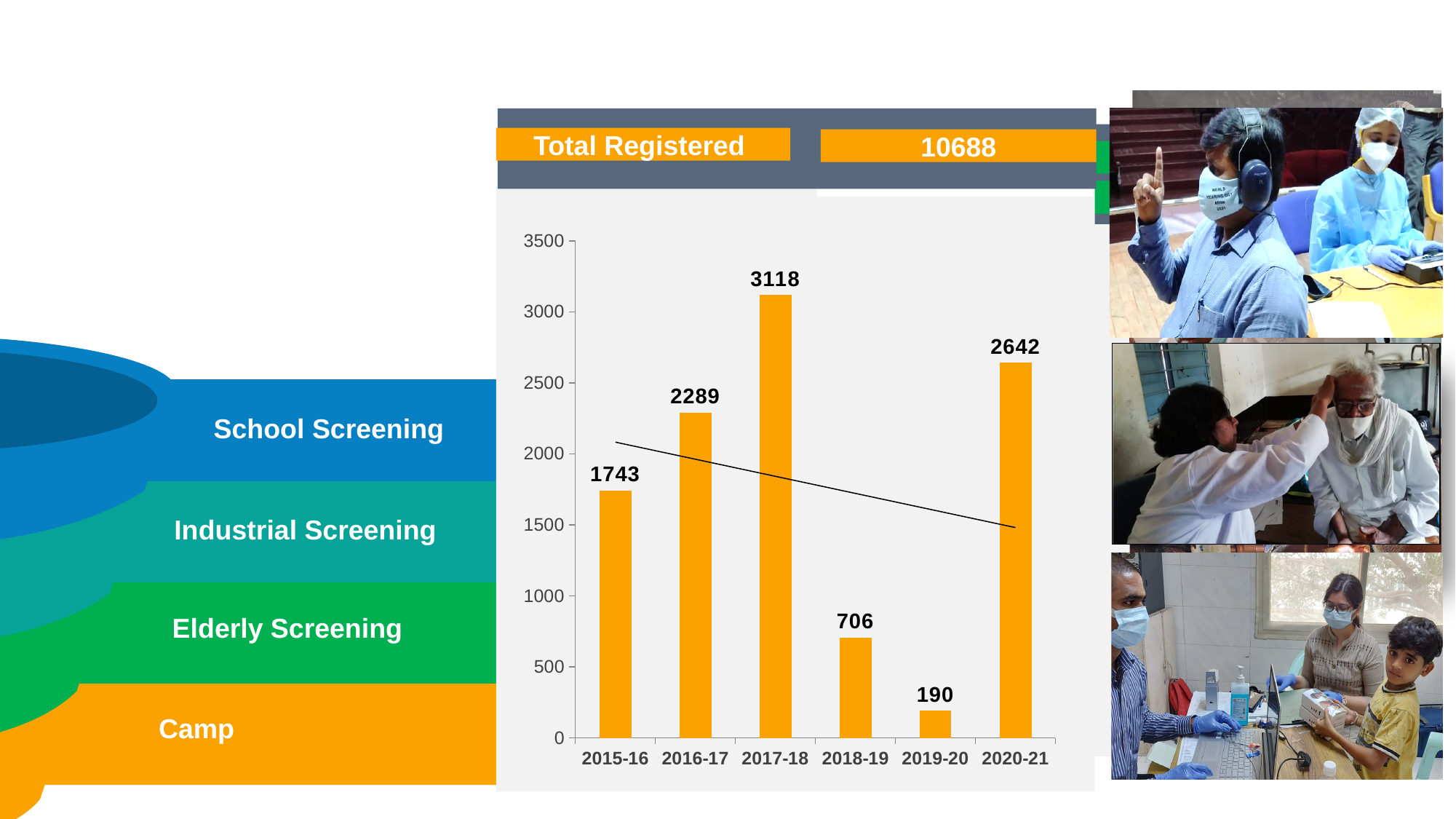
What total registered figure is shown above the chart? 10688 Which year has the lowest value? 2019-20 What is the difference between the values for 2017-18 and 2020-21? 476 Which is larger, the value for 2016-17 or the value for 2020-21? 2020-21 Is the value for 2018-19 greater or less than 1000? less What is the difference between the values for 2016-17 and 2018-19? 1583 What is the value for 2019-20? 190 What is the value for 2015-16? 1743 What is the value for 2017-18? 3118 How many years are shown on the x axis? 6 What kind of chart is shown on the slide? bar chart Which year has the highest value? 2017-18